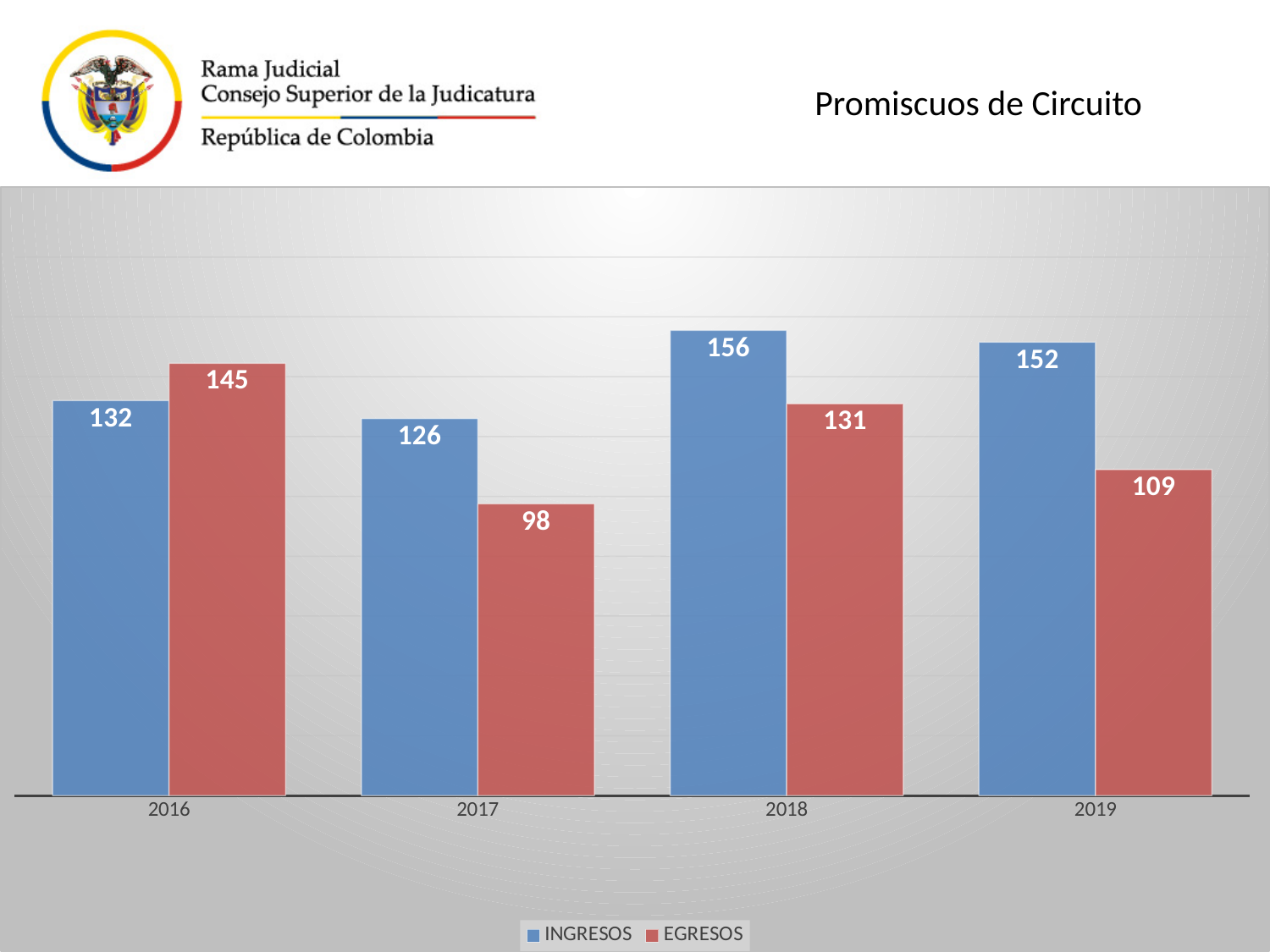
What kind of chart is shown on the slide? Bar chart What colour are the INGRESOS bars? Blue How many years are shown on the x axis? 4 Which is larger in 2016, INGRESOS or EGRESOS? EGRESOS What is the EGRESOS value for 2016? 145 What is the EGRESOS value for 2017? 98 What is the difference between INGRESOS and EGRESOS in 2019? 43 Which year has the lowest EGRESOS value? 2017 How many series does the legend list? 2 Does the EGRESOS value rise or fall from 2018 to 2019? Fall What is the INGRESOS value for 2018? 156 Which year has the highest INGRESOS value? 2018